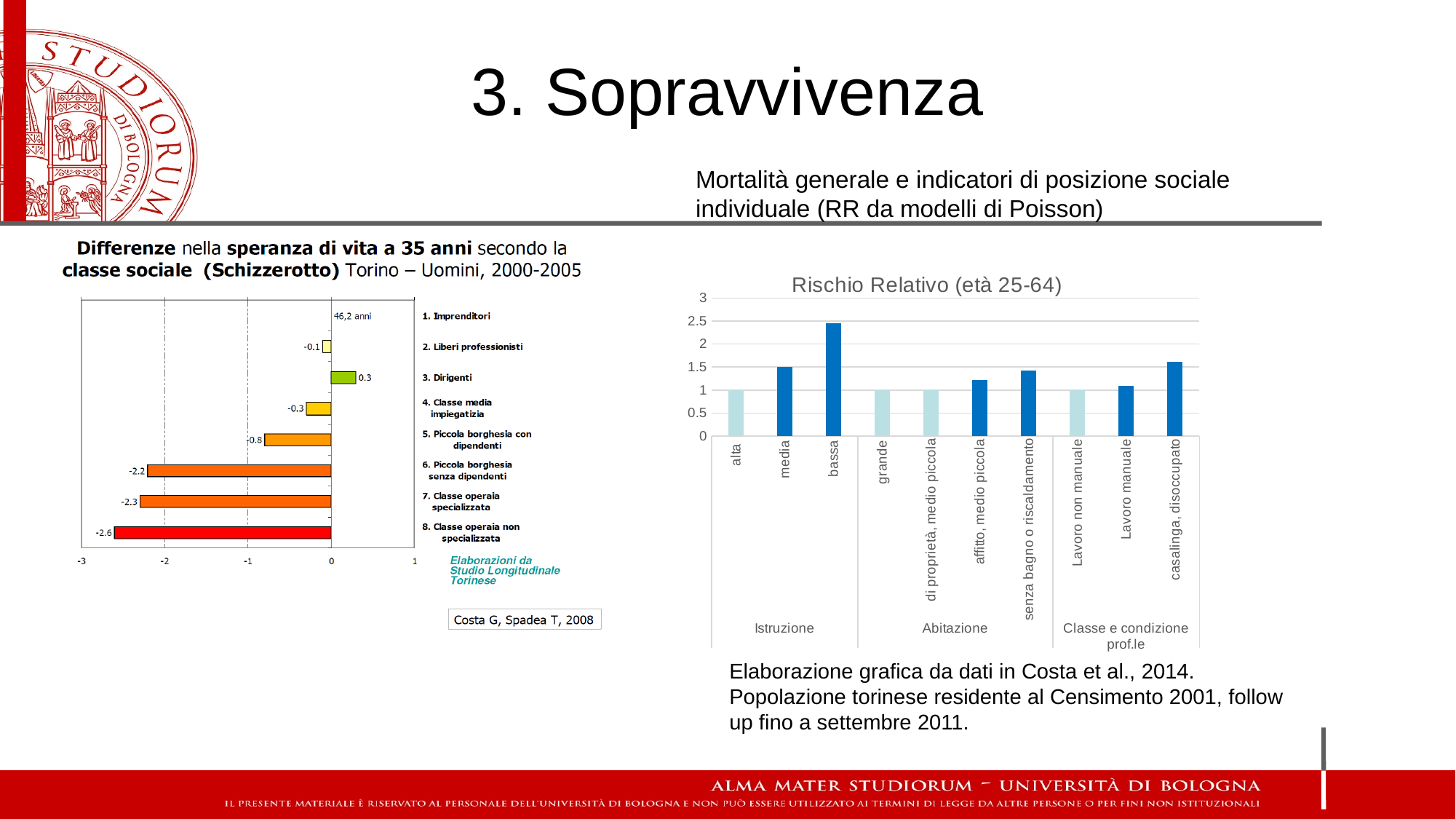
In the left chart (Differenze nella speranza di vita a 35 anni), what is the difference between the values for 'Piccola borghesia senza dipendenti' and 'Classe operaia specializzata'? 0.1 In the left chart (Differenze nella speranza di vita a 35 anni), which class has the lowest value? Classe operaia non specializzata What kind of chart is the 'Rischio Relativo (età 25-64)' chart on the right? bar chart In the left chart (Differenze nella speranza di vita a 35 anni), what life expectancy is shown for 'Imprenditori'? 46,2 anni In the 'Rischio Relativo (età 25-64)' chart, is the value for 'casalinga, disoccupato' greater or less than 'Lavoro manuale'? greater In the left chart (Differenze nella speranza di vita a 35 anni), what is the value for 'Piccola borghesia con dipendenti'? -0.8 In the 'Rischio Relativo (età 25-64)' chart, is the value for 'bassa' greater or less than 2? greater In the 'Rischio Relativo (età 25-64)' chart, which category has the highest value? bassa In the left chart (Differenze nella speranza di vita a 35 anni), what is the value for 'Dirigenti'? 0.3 In the left chart (Differenze nella speranza di vita a 35 anni), what is the value for 'Classe operaia non specializzata'? -2.6 In the left chart (Differenze nella speranza di vita a 35 anni), which class has the highest value? Dirigenti How many categories are plotted in the 'Rischio Relativo (età 25-64)' chart? 10